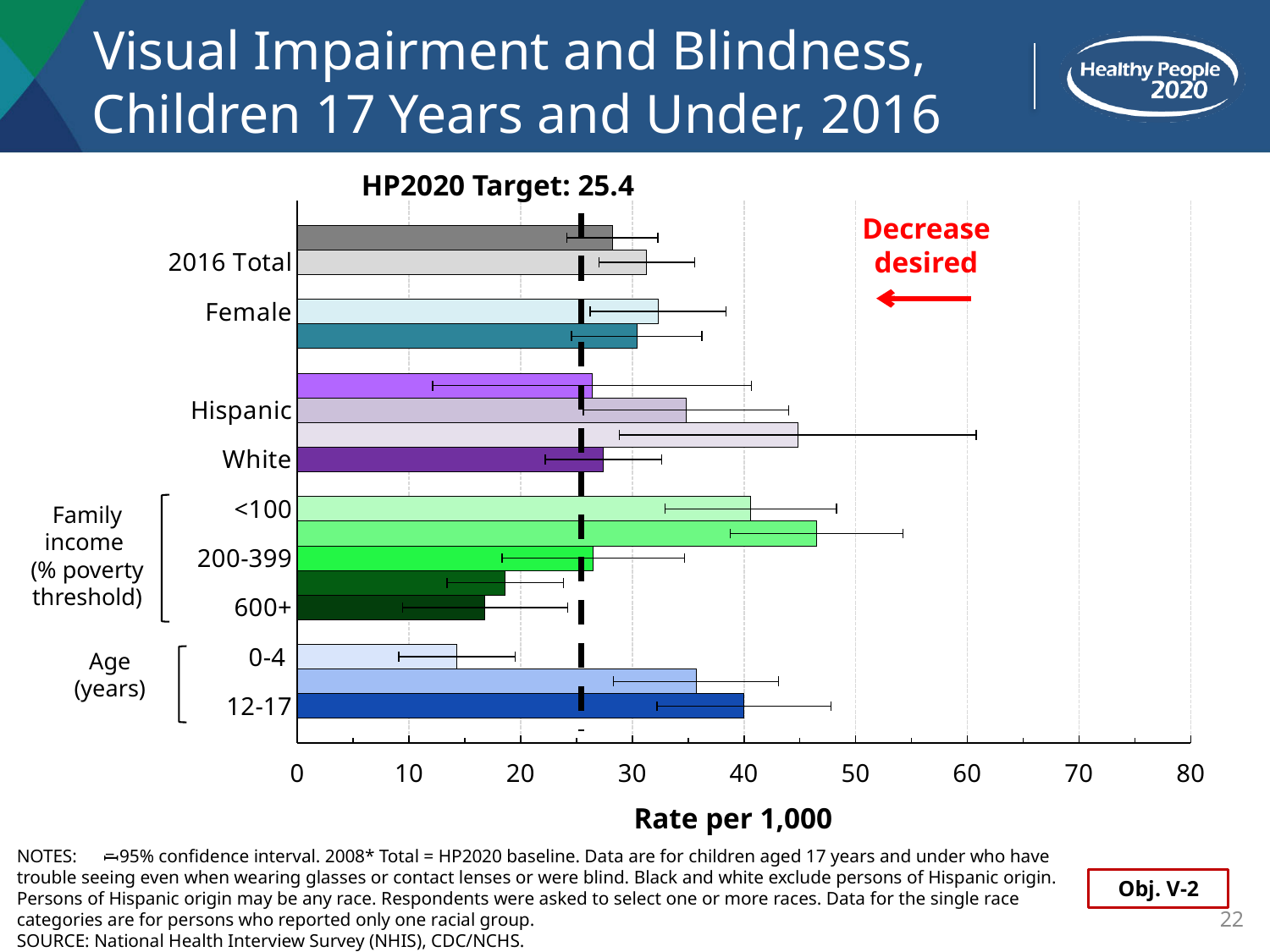
What is the title of the x axis? Rate per 1,000 Is the value for Female greater or less than 30? greater Is the value for Hispanic greater or less than 30? greater Which has the larger value, the 12-17 age group or the 0-4 age group? 12-17 Is the value for the 600+ family income group greater or less than 20? less Which has the larger value, Hispanic or White? Hispanic What kind of chart is shown on the slide? bar chart What is the HP2020 Target value shown above the chart? 25.4